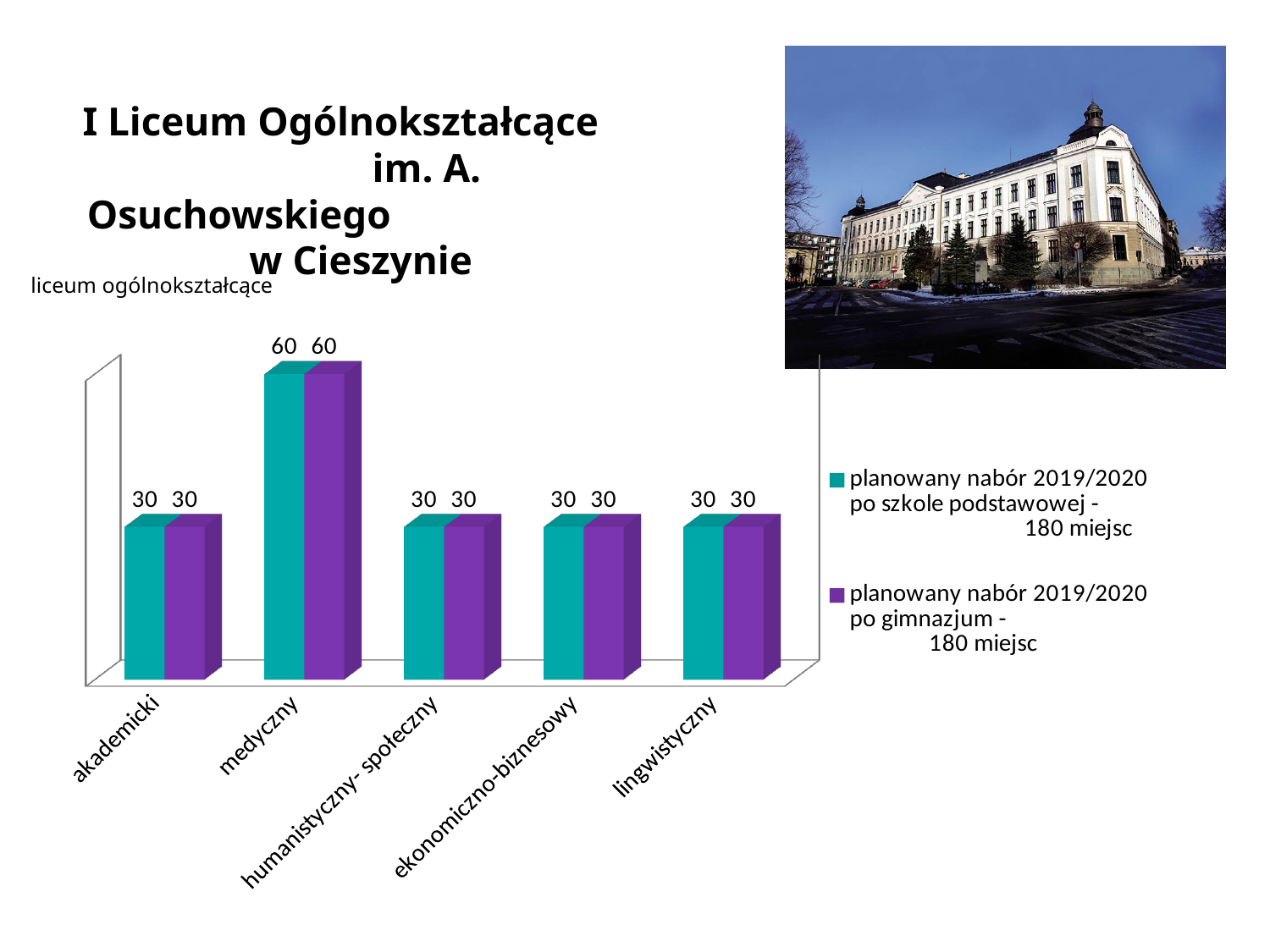
What is the title of the chart? liceum ogólnokształcące Which colour represents the series 'planowany nabór 2019/2020 po gimnazjum - 180 miejsc'? purple What is the difference between the values for medyczny and ekonomiczno-biznesowy in the series 'planowany nabór 2019/2020 po szkole podstawowej - 180 miejsc'? 30 Which is larger in the series 'planowany nabór 2019/2020 po gimnazjum - 180 miejsc': medyczny or humanistyczny- społeczny? medyczny How many series does the chart's legend list? 2 What kind of chart is shown on the slide? bar chart How many categories are shown on the x axis of the chart? 5 Which category has the highest value in the series 'planowany nabór 2019/2020 po gimnazjum - 180 miejsc'? medyczny What is the value for lingwistyczny in the series 'planowany nabór 2019/2020 po szkole podstawowej - 180 miejsc'? 30 What is the total of the two series values for medyczny? 120 What is the value for medyczny in the series 'planowany nabór 2019/2020 po szkole podstawowej - 180 miejsc'? 60 What is the value for akademicki in the series 'planowany nabór 2019/2020 po gimnazjum - 180 miejsc'? 30